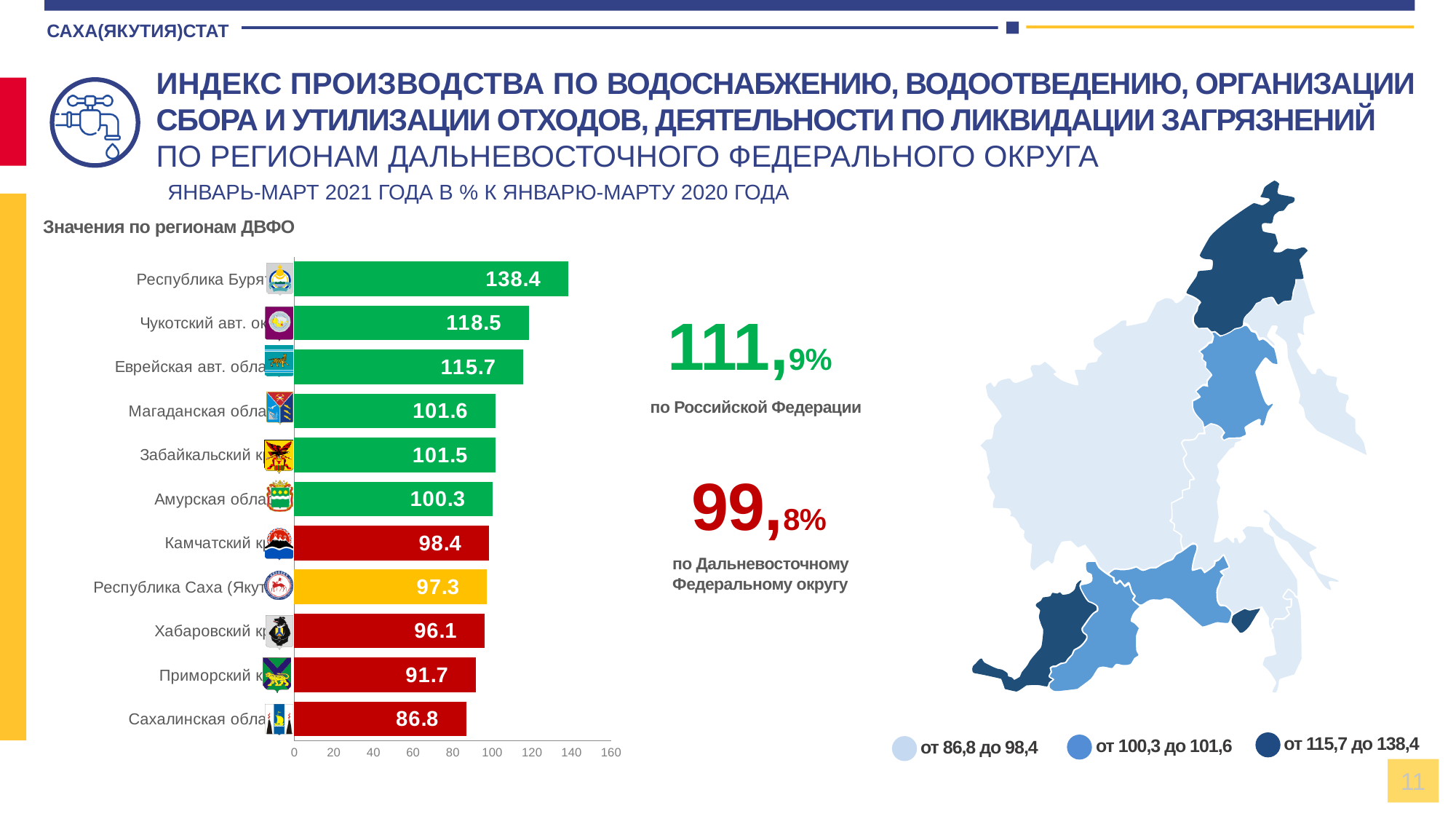
What is the value for Республика Бурятия in the bar chart? 138.4 Which region has the lowest value in the bar chart? Сахалинская область What kind of chart is used to show the values by region? bar chart What is the difference between the values for Республика Бурятия and Сахалинская область? 51.6 Which region has the highest value in the bar chart? Республика Бурятия What value is shown for the Russian Federation (по Российской Федерации) on the slide? 111,9% What colour is the bar for Республика Саха (Якутия)? yellow Which is larger, the value for Камчатский край or the value for Хабаровский край? Камчатский край How many regions are shown in the bar chart? 11 What is the value for Сахалинская область in the bar chart? 86.8 What is the difference between the values for Чукотский авт. округ and Еврейская авт. область? 2.8 What is the value for Республика Саха (Якутия) in the bar chart? 97.3